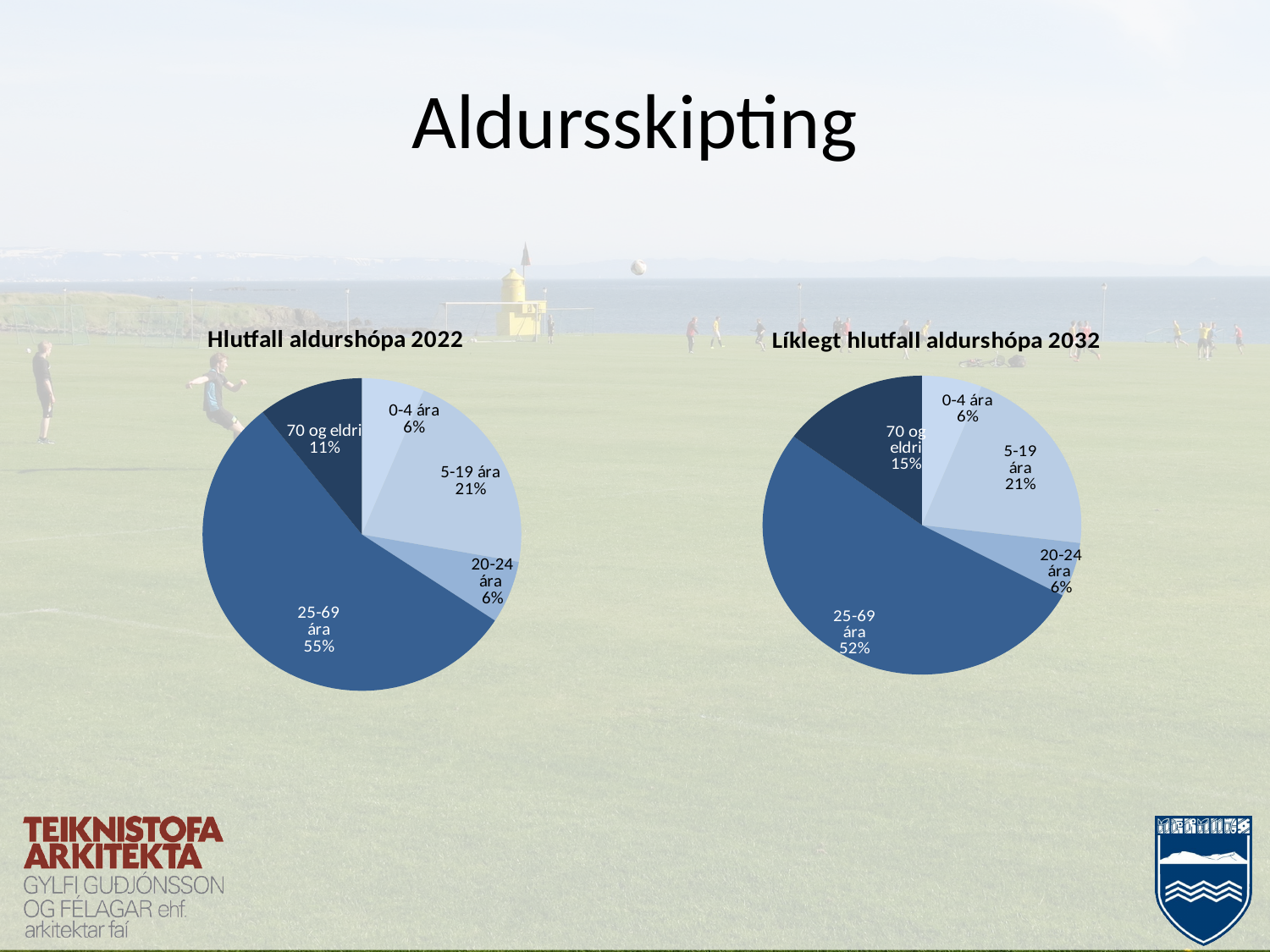
In the 'Hlutfall aldurshópa 2022' chart, which age group has the largest share? 25-69 ára In the 'Hlutfall aldurshópa 2022' chart, what is the difference between the shares for 25-69 ára and 70 og eldri? 44% Which chart shows a larger share for 70 og eldri, 'Hlutfall aldurshópa 2022' or 'Líklegt hlutfall aldurshópa 2032'? Líklegt hlutfall aldurshópa 2032 In the 'Líklegt hlutfall aldurshópa 2032' chart, what share is shown for 25-69 ára? 52% How many age groups are shown in the 'Hlutfall aldurshópa 2022' chart? 5 In the 'Líklegt hlutfall aldurshópa 2032' chart, which age group has the largest share? 25-69 ára What kind of chart is 'Líklegt hlutfall aldurshópa 2032'? Pie chart In the 'Líklegt hlutfall aldurshópa 2032' chart, what is the difference between the shares for 5-19 ára and 70 og eldri? 6% In the 'Hlutfall aldurshópa 2022' chart, what share is shown for 5-19 ára? 21% What is the title of the chart on the left of the slide? Hlutfall aldurshópa 2022 In the 'Hlutfall aldurshópa 2022' chart, what share is shown for 25-69 ára? 55% In the 'Líklegt hlutfall aldurshópa 2032' chart, what share is shown for 70 og eldri? 15%